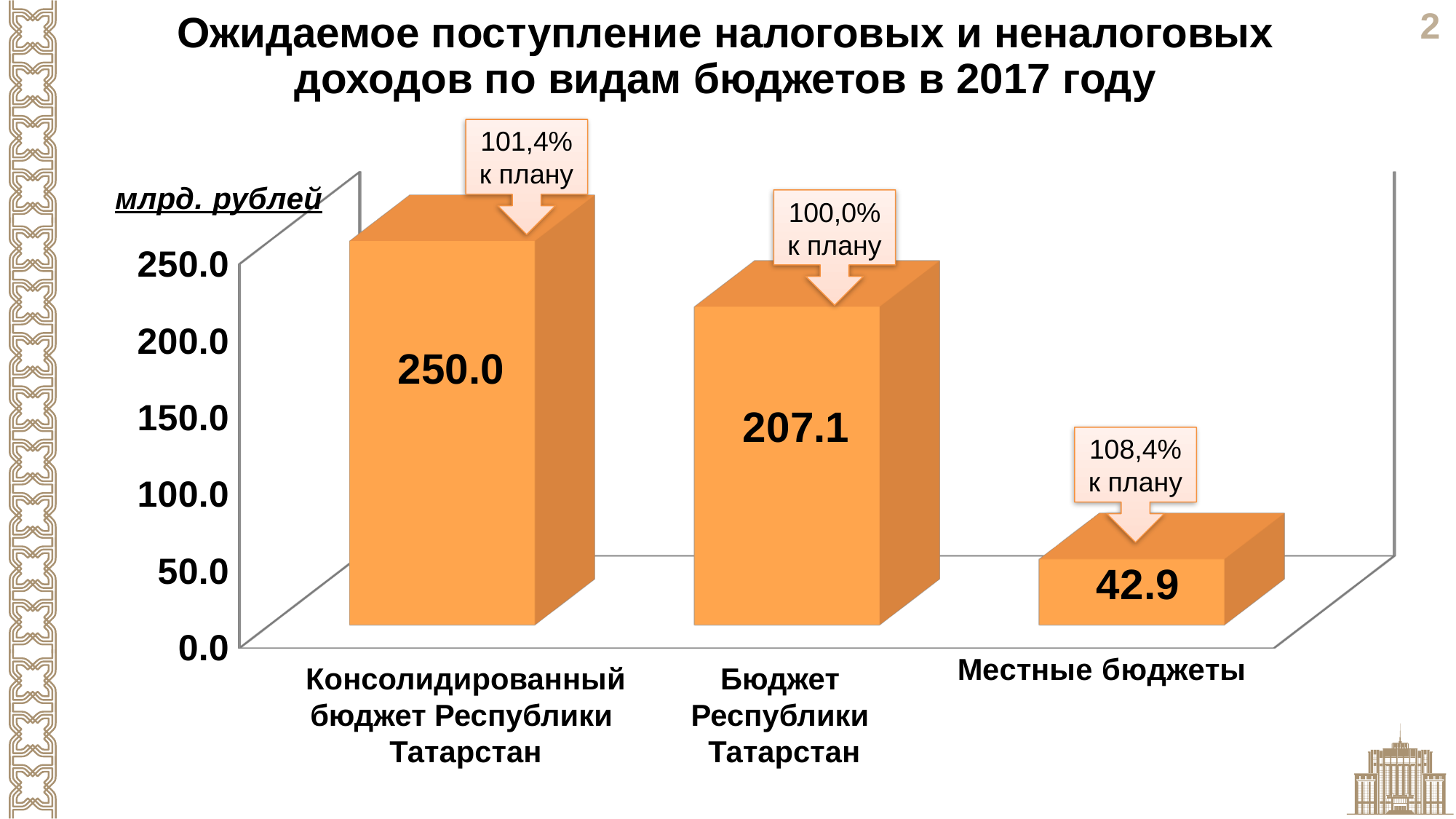
What is the value for Консолидированный бюджет Республики Татарстан? 250.0 What percentage of plan is shown in the callout above the Местные бюджеты bar? 108,4% к плану How many categories are shown in the chart? 3 What unit of measurement is indicated on the chart? млрд. рублей What is the difference between the values for Консолидированный бюджет Республики Татарстан and Бюджет Республики Татарстан? 42.9 Which category has the lowest value? Местные бюджеты What is the value for Местные бюджеты? 42.9 Which category has the highest value? Консолидированный бюджет Республики Татарстан What is the value for Бюджет Республики Татарстан? 207.1 What kind of chart is shown on the slide? Bar chart What is the difference between the values for Бюджет Республики Татарстан and Местные бюджеты? 164.2 Which is larger: the value for Бюджет Республики Татарстан or the value for Местные бюджеты? Бюджет Республики Татарстан